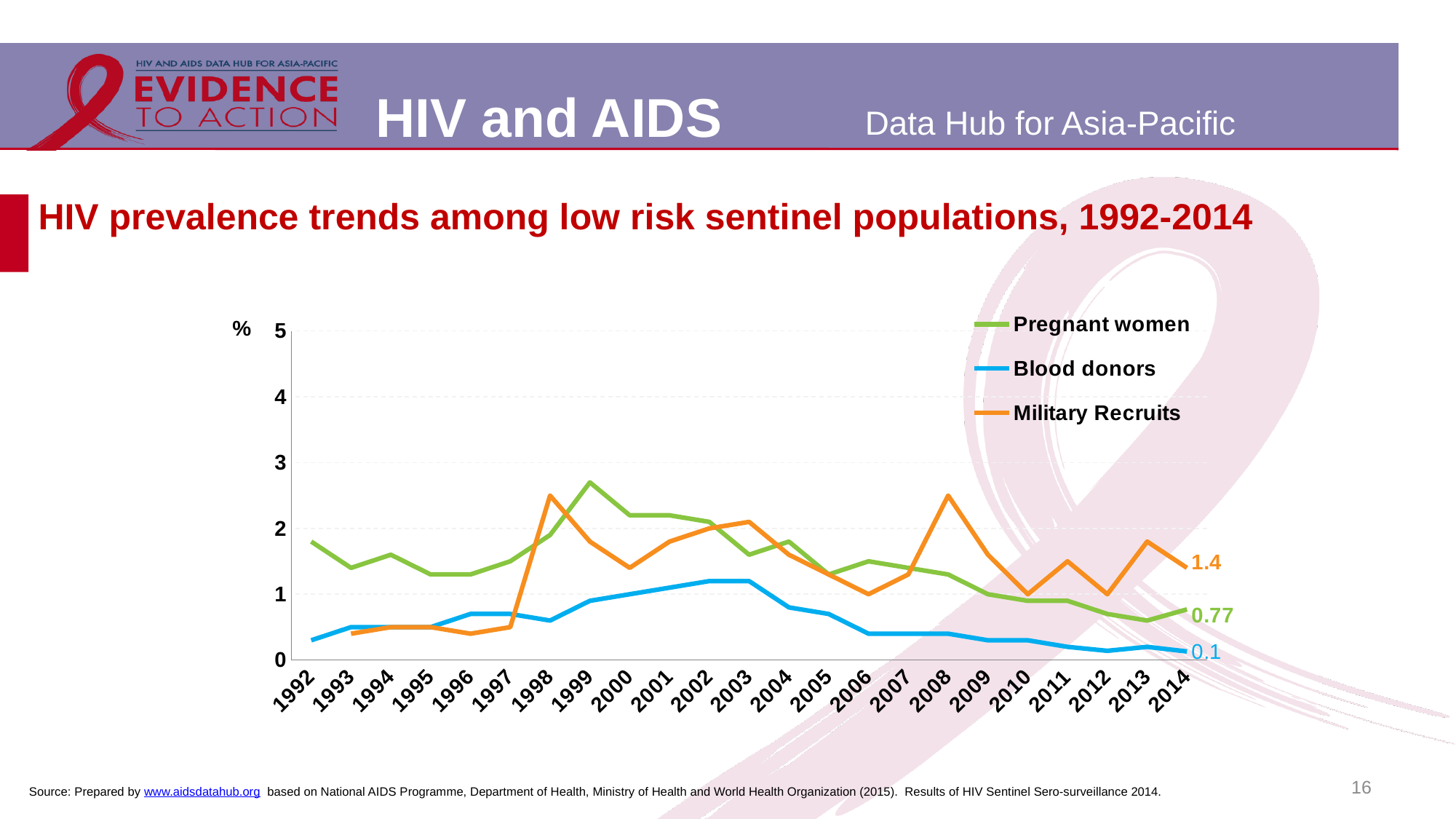
Which series has the lowest value in 2014? Blood donors What is the labelled value for Blood donors in 2014? 0.1 What is the labelled value for Military Recruits in 2014? 1.4 How many series does the legend list? 3 In 2014, which is larger: the value for Pregnant women or the value for Blood donors? Pregnant women Is the value for Blood donors in 2006 greater or less than 1? less What kind of chart is shown on the slide? Line chart What is the labelled value for Pregnant women in 2014? 0.77 Which series has the highest value in 2014? Military Recruits What is the difference between the 2014 values for Military Recruits and Pregnant women? 0.63 Is the value for Pregnant women in 1999 greater or less than 2? greater How many years are shown along the x axis? 23